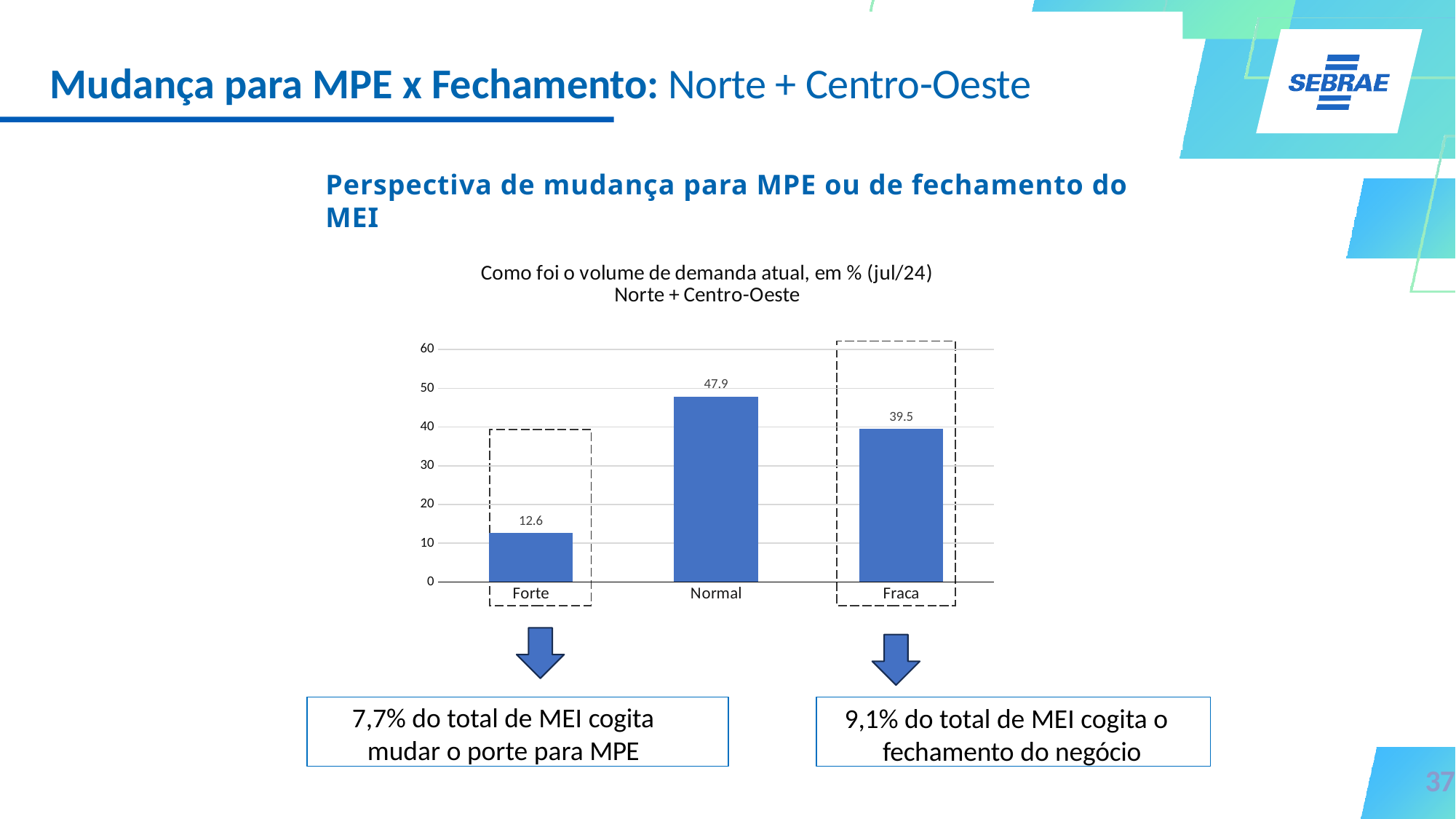
Which is larger, the value for Forte or the value for Fraca? Fraca How many categories are shown on the x axis? 3 Which category has the highest value? Normal Is the value for Normal greater or less than 40? greater Which category has the lowest value? Forte What is the value for Forte? 12.6 What is the value for Normal? 47.9 What is the difference between the values for Normal and Fraca? 8.4 What is the value for Fraca? 39.5 What is the difference between the values for Fraca and Forte? 26.9 What is the title of the chart? Como foi o volume de demanda atual, em % (jul/24) Norte + Centro-Oeste What kind of chart is shown on the slide? bar chart